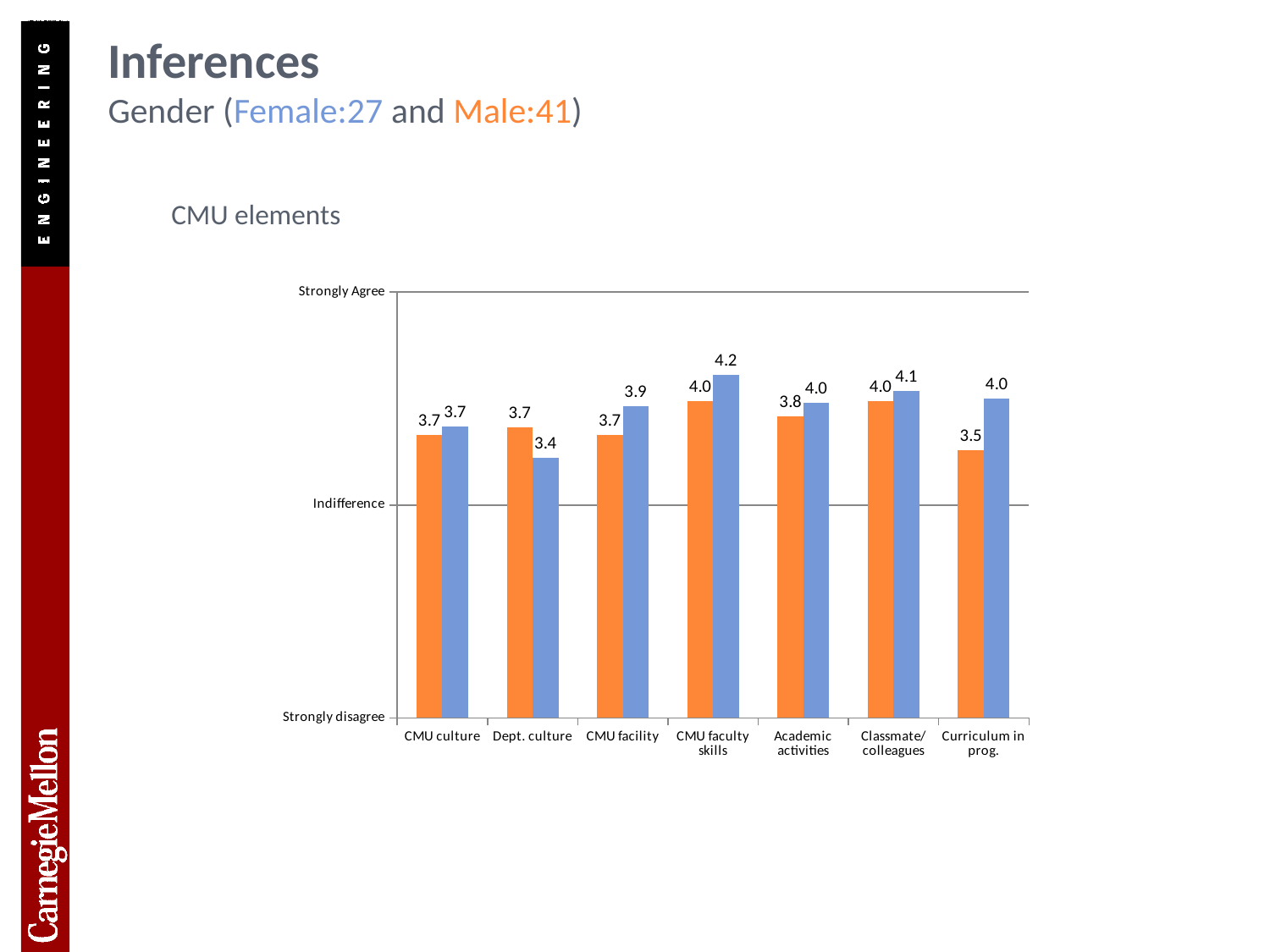
What is the value of the blue bar for Dept. culture? 3.4 What is the value of the orange bar for Curriculum in prog.? 3.5 How many categories are shown on the x axis of the chart? 7 For Dept. culture, how much higher is the orange bar than the blue bar? 0.3 Which category has the lowest blue bar? Dept. culture For CMU facility, which bar is larger, the orange or the blue? blue Which category has the highest blue bar? CMU faculty skills What is the value of the blue bar for CMU faculty skills? 4.2 For Curriculum in prog., how much higher is the blue bar than the orange bar? 0.5 What is the value of the orange bar for Academic activities? 3.8 Which category has the lowest orange bar? Curriculum in prog. What kind of chart is shown on the slide? bar chart